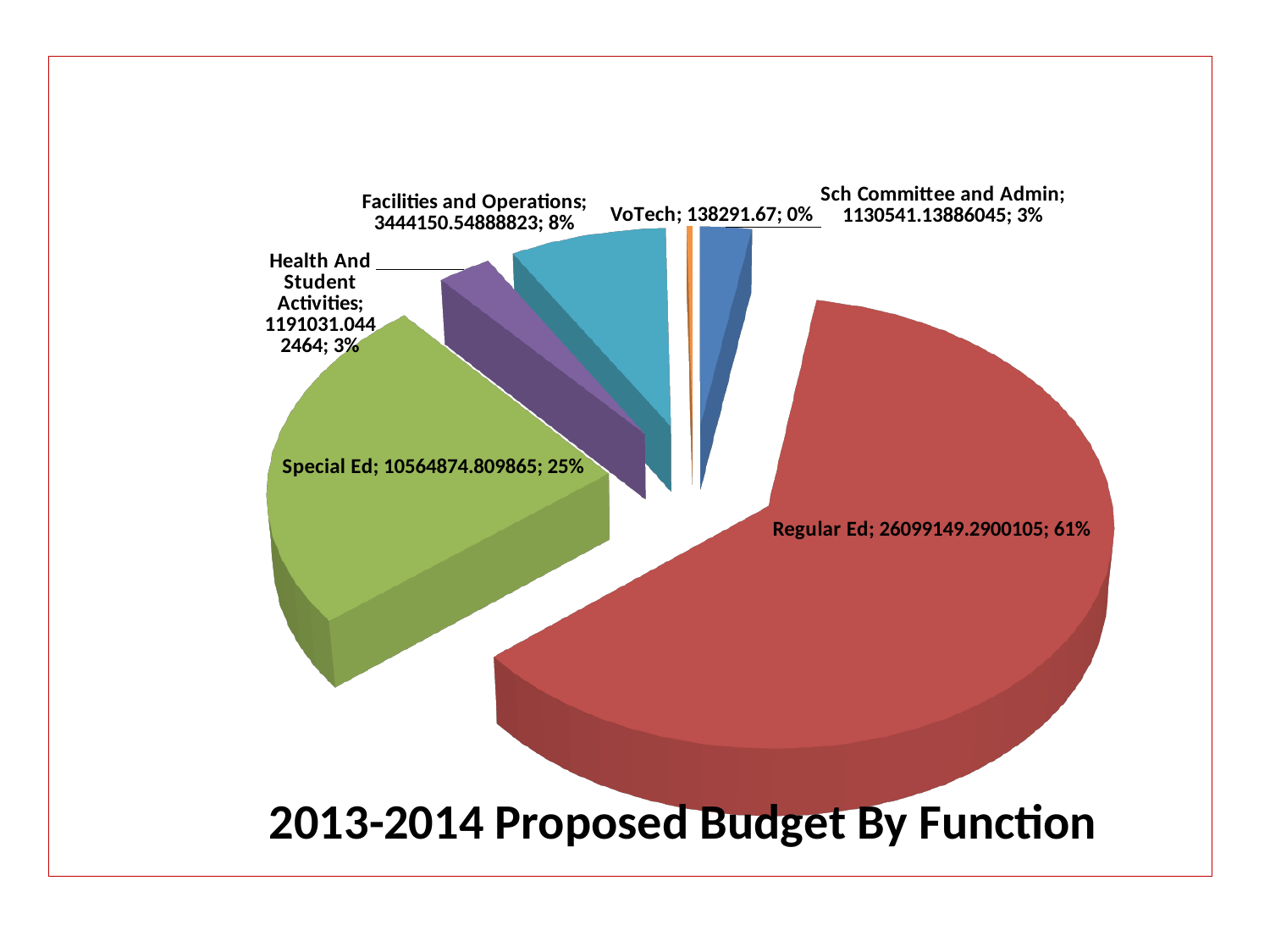
Which has the larger value, Health And Student Activities or Sch Committee and Admin? Health And Student Activities What percentage of the budget goes to Facilities and Operations? 8% How many slices does the pie chart have? 6 What percentage of the budget goes to Special Ed? 25% What kind of chart is shown on the slide? Pie chart What is the value shown for Sch Committee and Admin? 1130541.13886045 Which function has the largest share of the proposed budget? Regular Ed By how many percentage points does Regular Ed's share exceed Special Ed's share? 36 percentage points What is the title of the chart? 2013-2014 Proposed Budget By Function What is the value shown for Regular Ed? 26099149.2900105 What is the value shown for VoTech? 138291.67 Which function has the smallest share of the proposed budget? VoTech